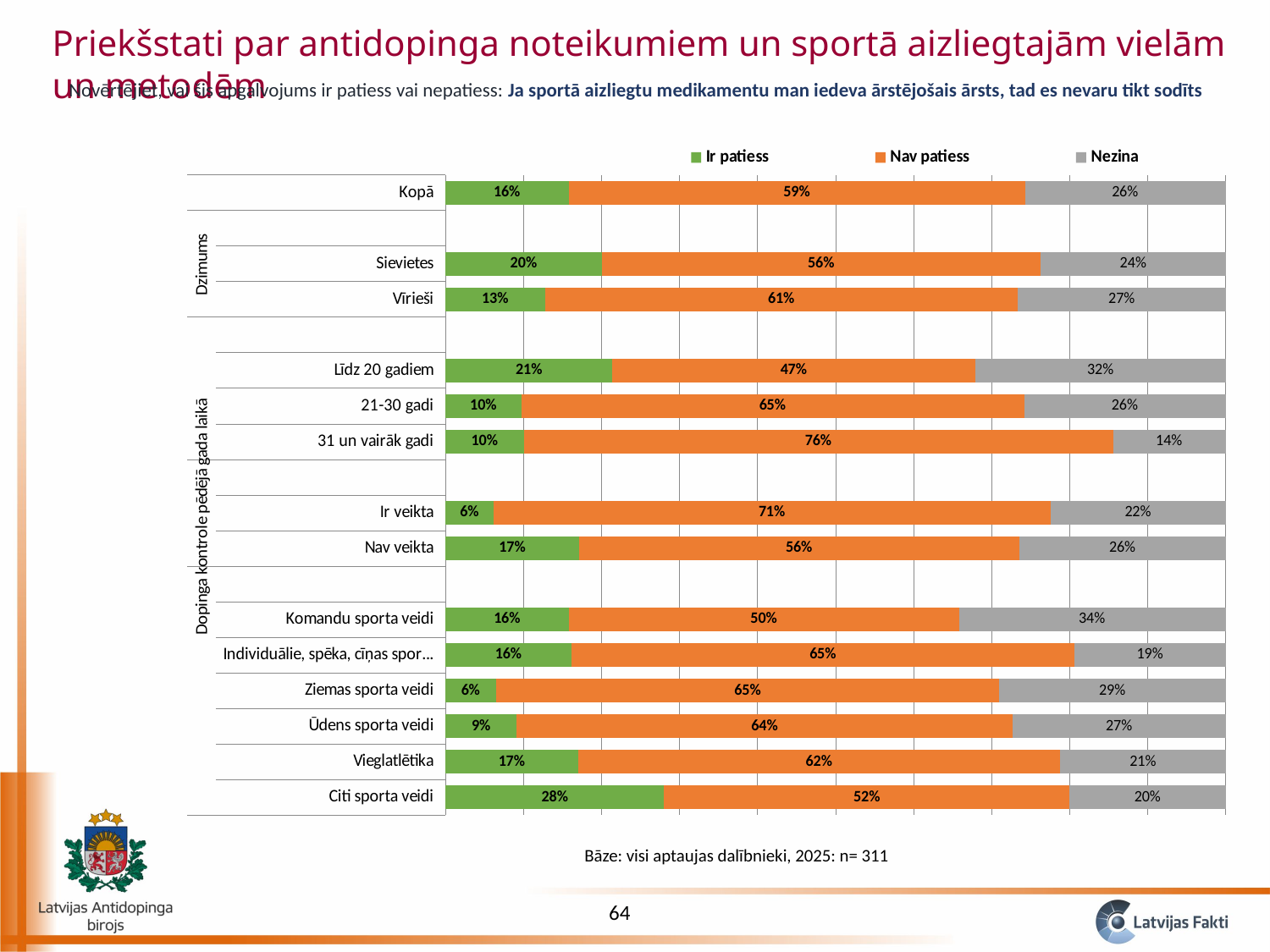
What is the "Nezina" value for Līdz 20 gadiem? 32% What is the total of the stacked bar for Komandu sporta veidi? 100% What kind of chart is shown on the slide? stacked bar chart How many categories are plotted on the chart? 14 How many series does the legend list? 3 Which is larger: the "Ir patiess" value for Vīrieši or for Sievietes? Sievietes What is the "Nav patiess" value for Kopā? 59% Which category has the lowest "Nezina" value? 31 un vairāk gadi What is the "Ir patiess" value for Sievietes? 20% What is the difference between the "Nav patiess" values for Ir veikta and Nav veikta? 15% Which category has the highest "Ir patiess" value? Citi sporta veidi Which category has the highest "Nav patiess" value? 31 un vairāk gadi